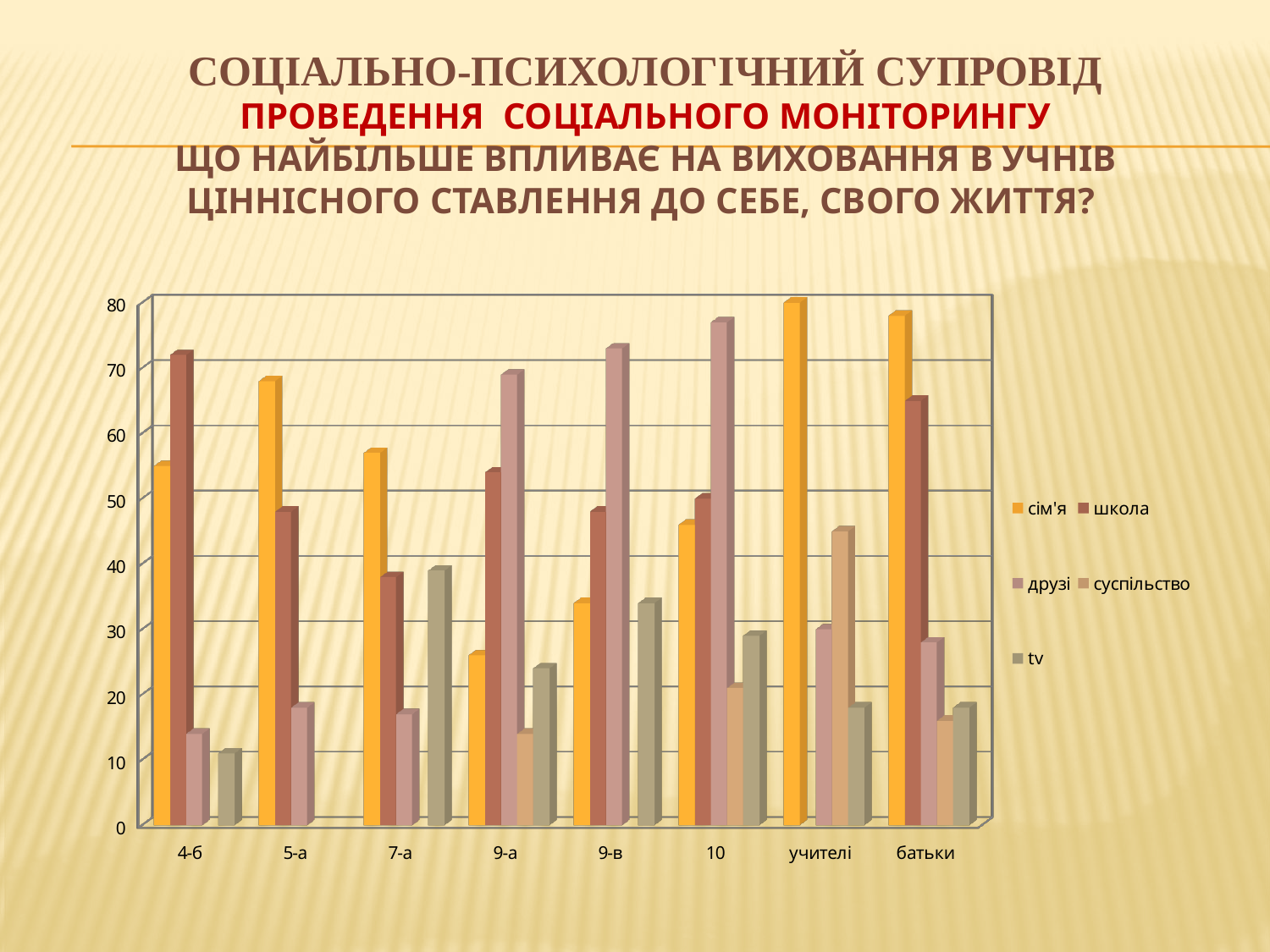
Is the value of сім'я for 9-а greater or less than 30? less Is the value of школа for 4-б greater or less than 60? greater Which series is listed first in the chart's legend? сім'я Is the value of друзі for 10 greater or less than 70? greater How many categories are shown along the x axis of the chart? 8 Which category has the lowest value for сім'я? 9-а What kind of chart is shown on the slide? bar chart How many series does the chart's legend list? 5 For 4-б, which is larger: сім'я or школа? школа Which category has the highest value for школа? 4-б